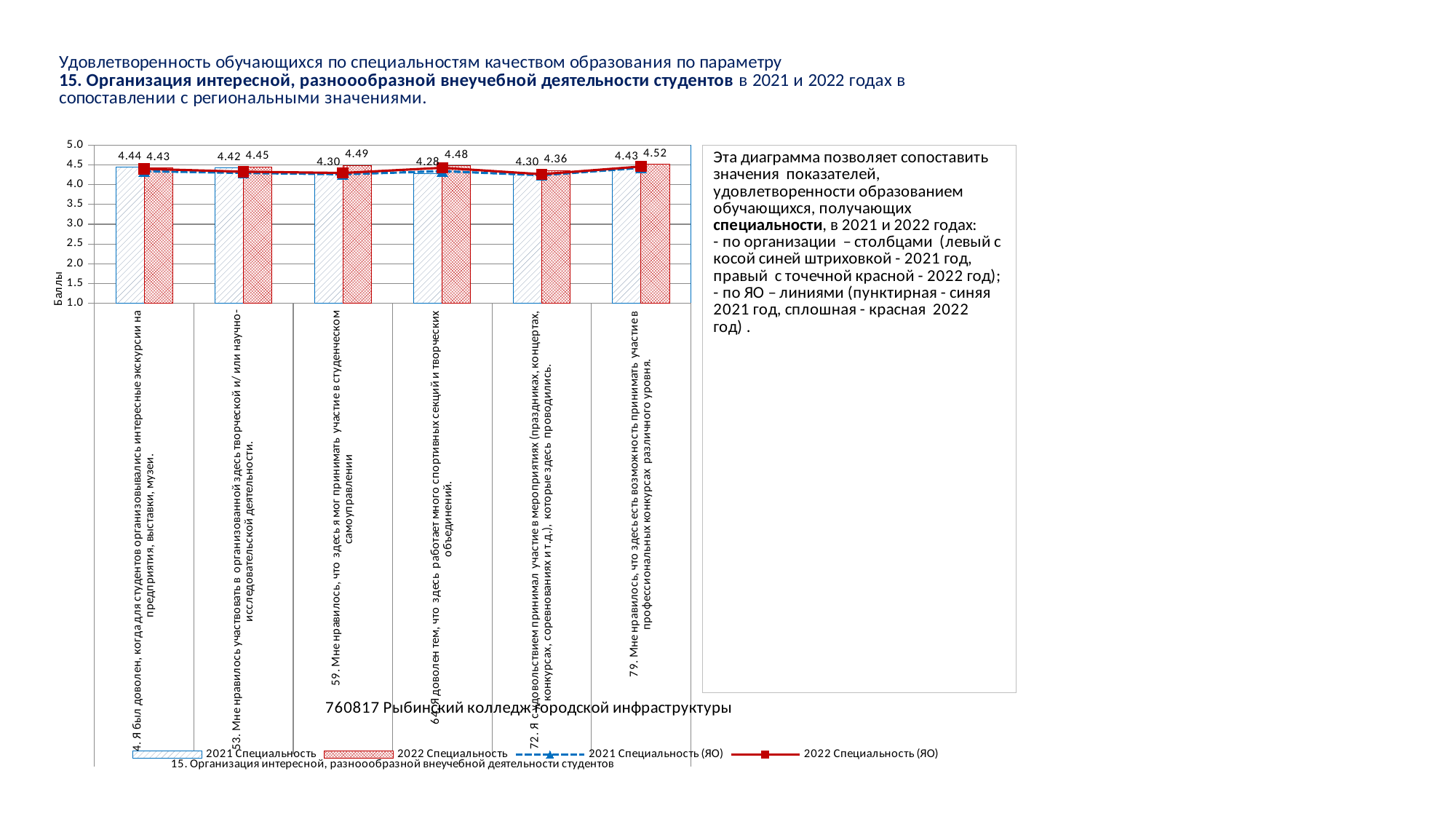
Which category has the highest 2022 Специальность value? 79. Мне нравилось, что здесь есть возможность принимать участие в профессиональных конкурсах различного уровня What is the value of the 2021 Специальность bar for category 4 (Я был доволен, когда для студентов организовывались интересные экскурсии на предприятия, выставки, музеи)? 4.44 What is the value of the 2021 Специальность bar for category 64 (Я доволен тем, что здесь работает много спортивных секций и творческих объединений)? 4.28 For category 4 (Я был доволен, когда для студентов организовывались интересные экскурсии...), which is larger: the 2021 Специальность value or the 2022 Специальность value? 2021 Специальность (4.44) What is the title of the vertical axis of the chart? Баллы Is the 2022 Специальность value for category 72 (Я с удовольствием принимал участие в мероприятиях...) greater or less than 4.0? greater What is the value of the 2022 Специальность bar for category 79 (Мне нравилось, что здесь есть возможность принимать участие в профессиональных конкурсах различного уровня)? 4.52 Which category has the lowest 2021 Специальность value? 64. Я доволен тем, что здесь работает много спортивных секций и творческих объединений By how much does the 2022 Специальность value exceed the 2021 Специальность value for category 59 (Мне нравилось, что здесь я мог принимать участие в студенческом самоуправлении)? 0.19 How many series does the chart legend list? 4 How many categories (questions) are shown on the x axis of the chart? 6 What kind of chart is shown on the slide? A combined bar and line chart